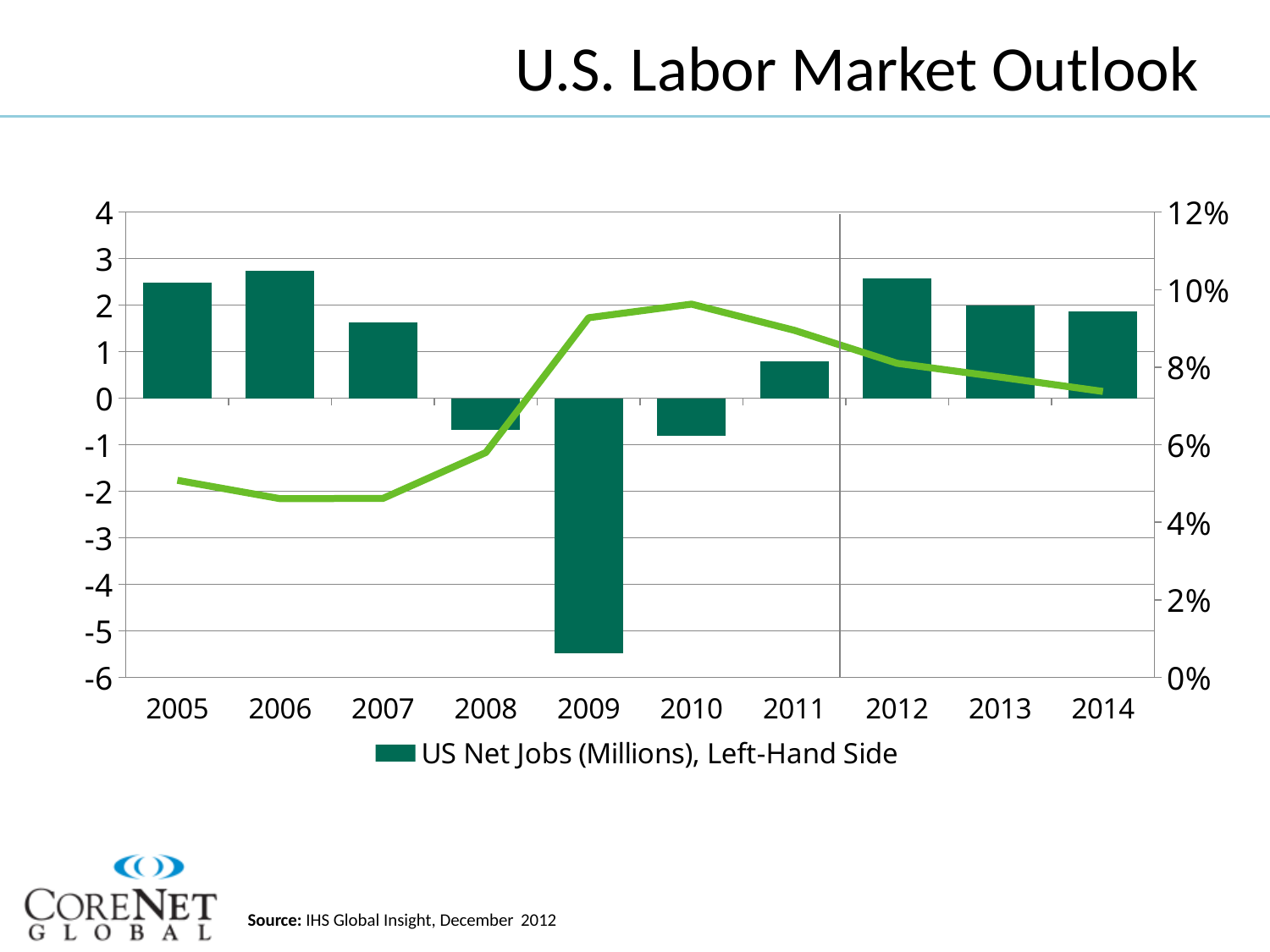
In which year does the green line reach its highest point? 2010 Is the US Net Jobs value for 2011 greater or less than 1? less Which year has the larger US Net Jobs value, 2005 or 2007? 2005 How many years are shown on the x axis of the chart? 10 Is the US Net Jobs value for 2005 greater or less than 2? greater Which year has the lowest value for US Net Jobs (Millions)? 2009 What kind of chart is shown on the slide? A bar chart combined with a line Does the green line rise or fall from 2010 to 2014? fall Is the US Net Jobs value for 2009 greater or less than -5? less What is the title of the chart on the slide? U.S. Labor Market Outlook Which year has the larger US Net Jobs value, 2011 or 2013? 2013 How many series does the legend list? 1